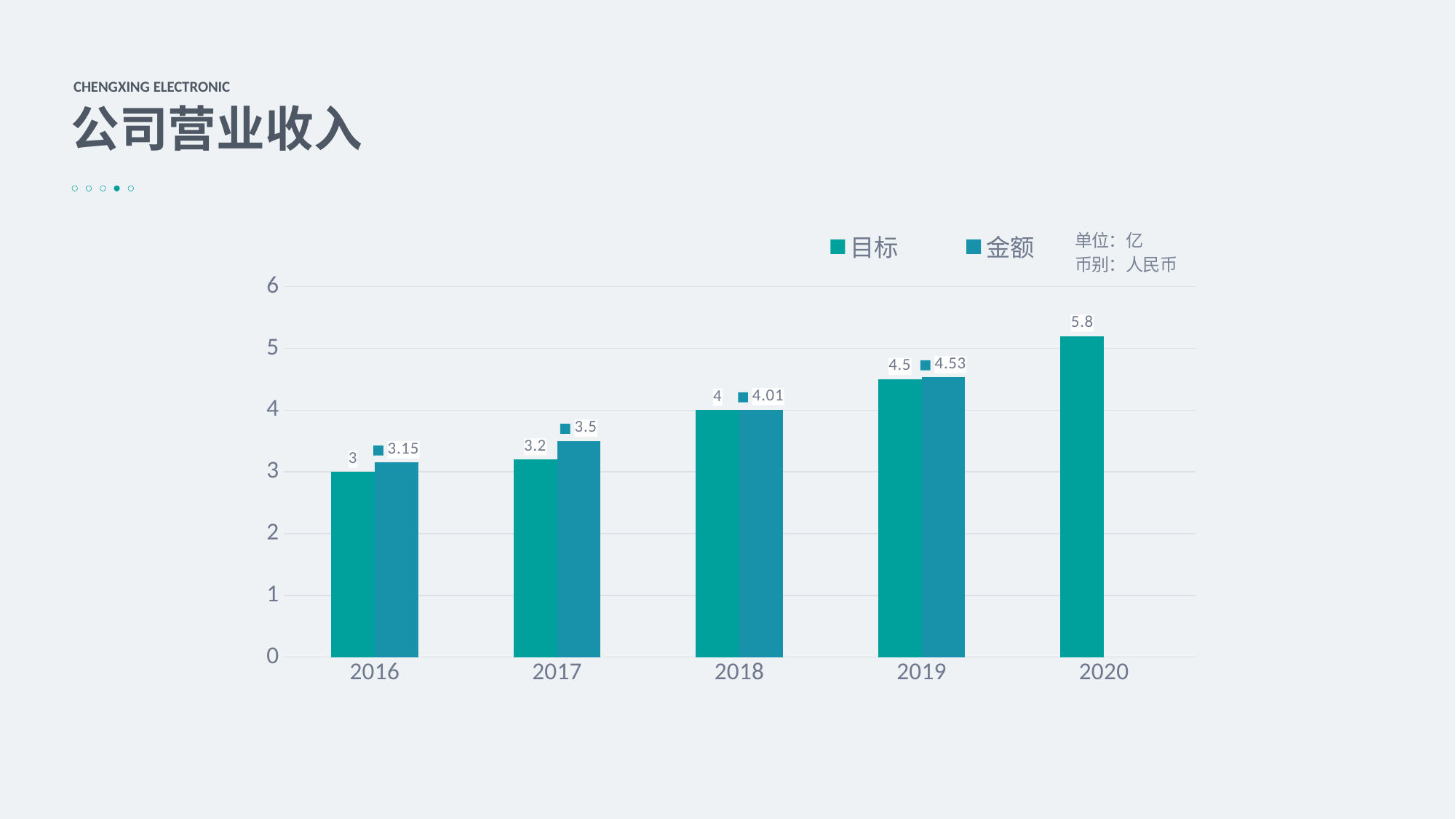
How many series does the legend list? 2 How many years are shown on the x axis? 5 What is the 金额 value for 2019? 4.53 What is the difference between the 金额 and 目标 values for 2016? 0.15 Which year has the lowest 金额 value? 2016 What is the 目标 value for 2020? 5.8 What is the 目标 value for 2018? 4 For 2017, which is larger, 目标 or 金额? 金额 What kind of chart is shown on the slide? Bar chart Which year has the highest 目标 value? 2020 Do the 目标 values rise or fall from 2016 to 2020? Rise What is the 金额 value for 2017? 3.5